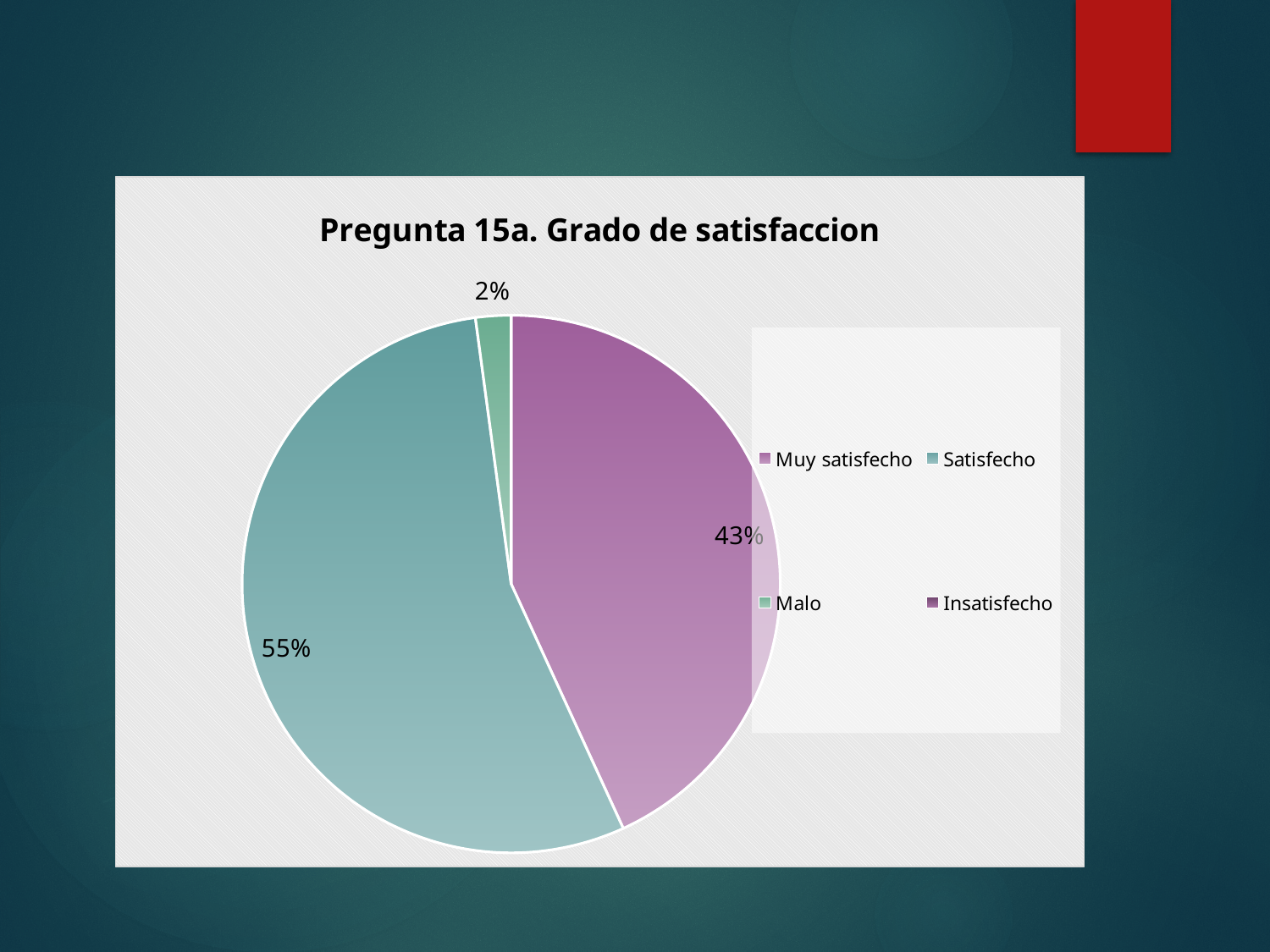
Which slice is larger, Satisfecho or Muy satisfecho? Satisfecho What percentage of the pie is labelled for Satisfecho? 55% What percentage is shown for the Muy satisfecho slice? 43% How many entries does the legend list? 4 What colour is the Muy satisfecho slice? Purple What is the title of the chart? Pregunta 15a. Grado de satisfaccion What is the difference in percentage points between the Satisfecho and Muy satisfecho slices? 12% What percentage is shown for the Malo slice? 2% Which category has the largest slice of the pie? Satisfecho What kind of chart is shown on the slide? Pie chart Which of the labelled slices has the smallest share? Malo What is the difference in percentage points between the Muy satisfecho and Malo slices? 41%